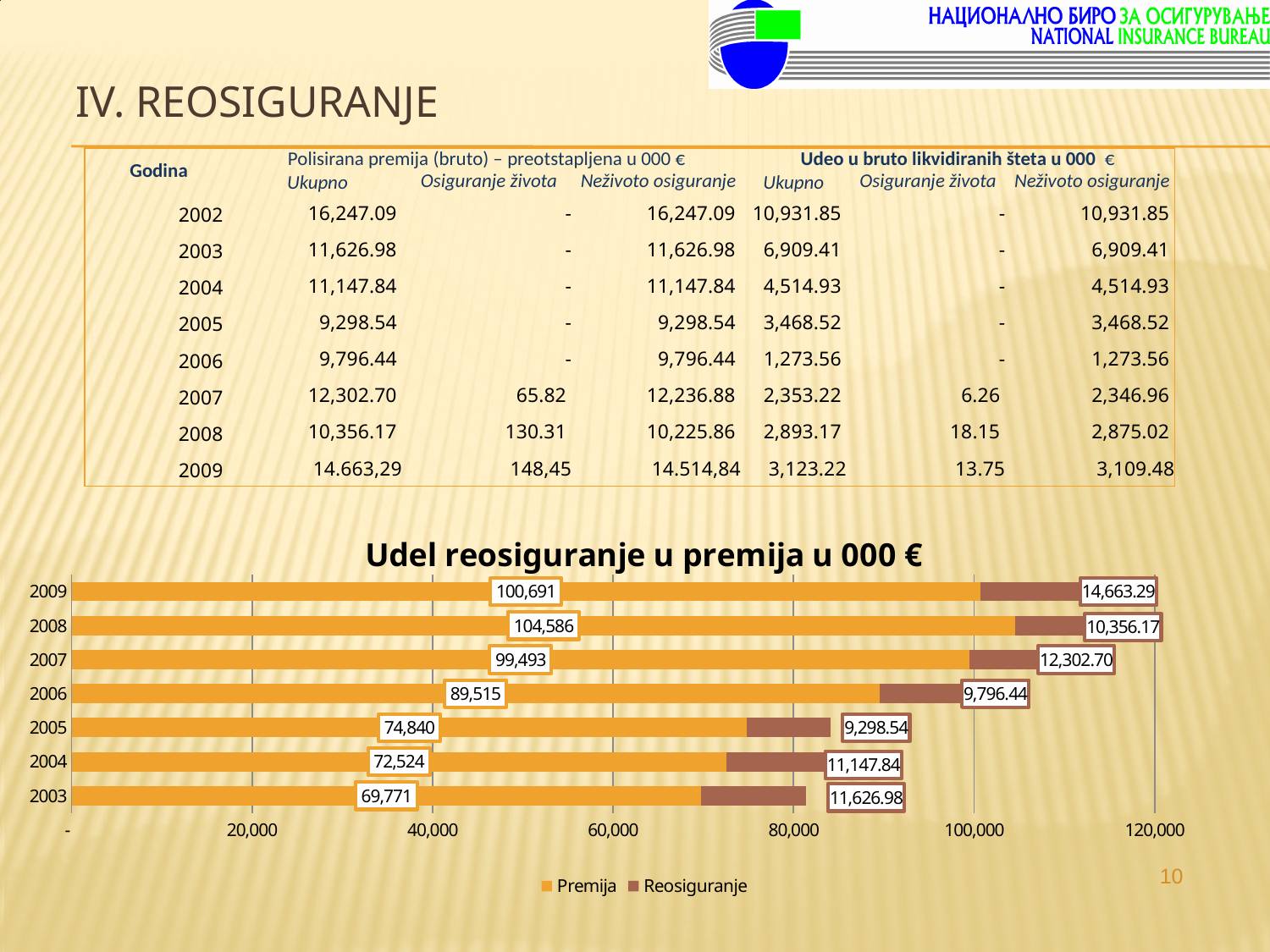
In the chart 'Udel reosiguranje u premija u 000 €', which year has the highest Premija value? 2008 In the chart 'Udel reosiguranje u premija u 000 €', what is the Premija value for 2008? 104,586 In the chart 'Udel reosiguranje u premija u 000 €', what is the difference between the Premija values for 2008 and 2009? 3,895 How many series does the legend of the chart 'Udel reosiguranje u premija u 000 €' list? 2 In the chart 'Udel reosiguranje u premija u 000 €', which year has the lowest Reosiguranje value? 2005 In the chart 'Udel reosiguranje u premija u 000 €', is the Reosiguranje value larger for 2007 or for 2008? 2007 In the chart 'Udel reosiguranje u premija u 000 €', what is the total of the stacked bar for 2009? 115,354.29 In the chart 'Udel reosiguranje u premija u 000 €', does the Premija value rise or fall from 2003 to 2008? rise What type of chart is shown under the title 'Udel reosiguranje u premija u 000 €'? bar chart How many years are shown in the chart 'Udel reosiguranje u premija u 000 €'? 7 In the chart 'Udel reosiguranje u premija u 000 €', what is the Reosiguranje value for 2006? 9,796.44 In the chart 'Udel reosiguranje u premija u 000 €', what is the Premija value for 2003? 69,771